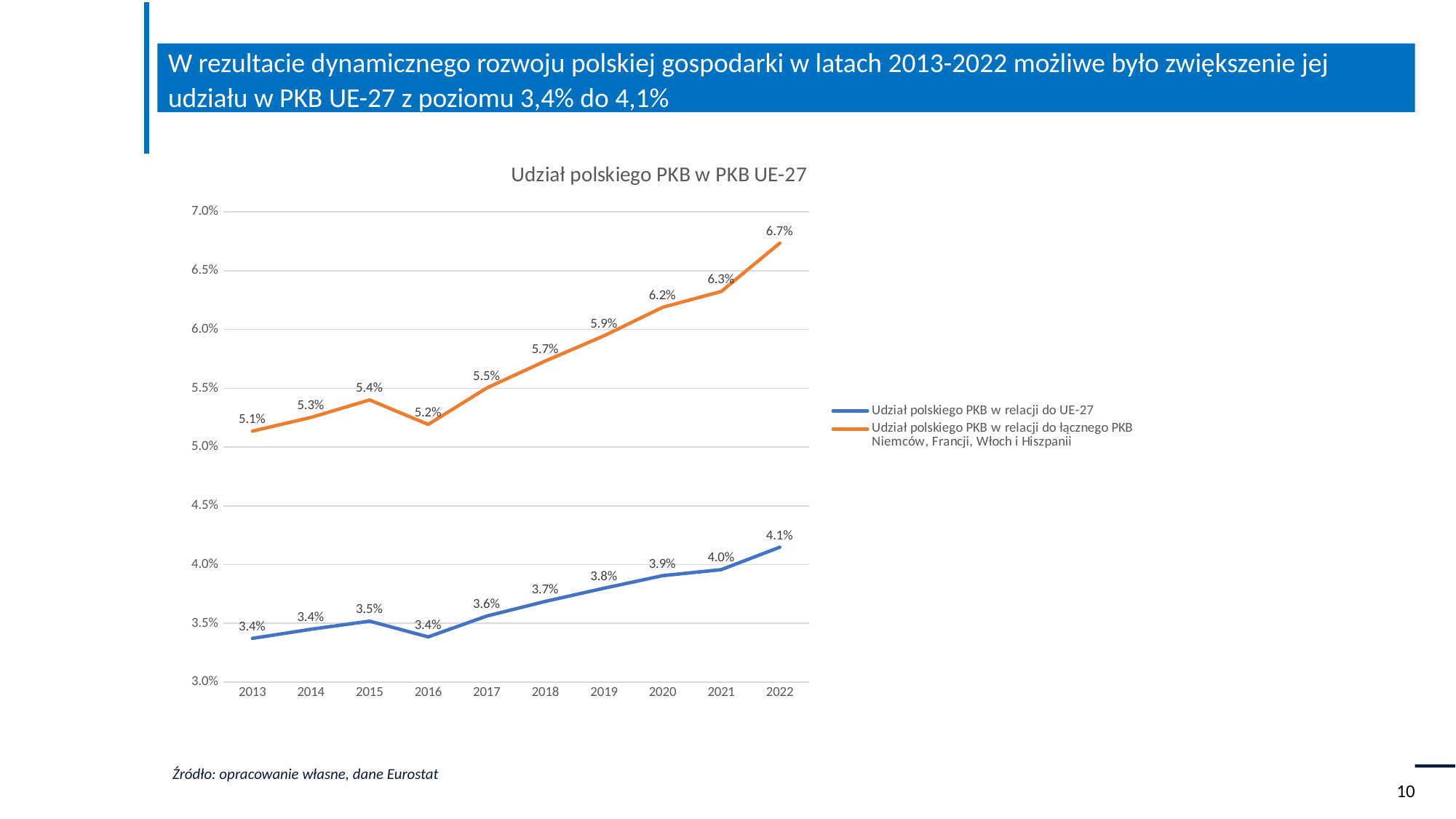
What kind of chart is shown on the slide? Line chart What is the value of the 'Udział polskiego PKB w relacji do łącznego PKB Niemców, Francji, Włoch i Hiszpanii' series in 2013? 5.1% What is the title of the chart? Udział polskiego PKB w PKB UE-27 In which year is the orange series (relative to Germany, France, Italy and Spain) at its lowest value? 2013 Which is larger: the blue series value in 2015 or in 2016? 2015 How many series does the legend list? 2 In which year does the 'Udział polskiego PKB w relacji do UE-27' series reach its highest value? 2022 What is the value of the orange series (relative to Germany, France, Italy and Spain) in 2019? 5.9% What is the value of the blue series (relative to UE-27) in 2018? 3.7% What is the difference between the orange series value in 2022 and in 2013? 1.6% How many years are shown on the x axis? 10 What is the value of the 'Udział polskiego PKB w relacji do UE-27' series in 2022? 4.1%